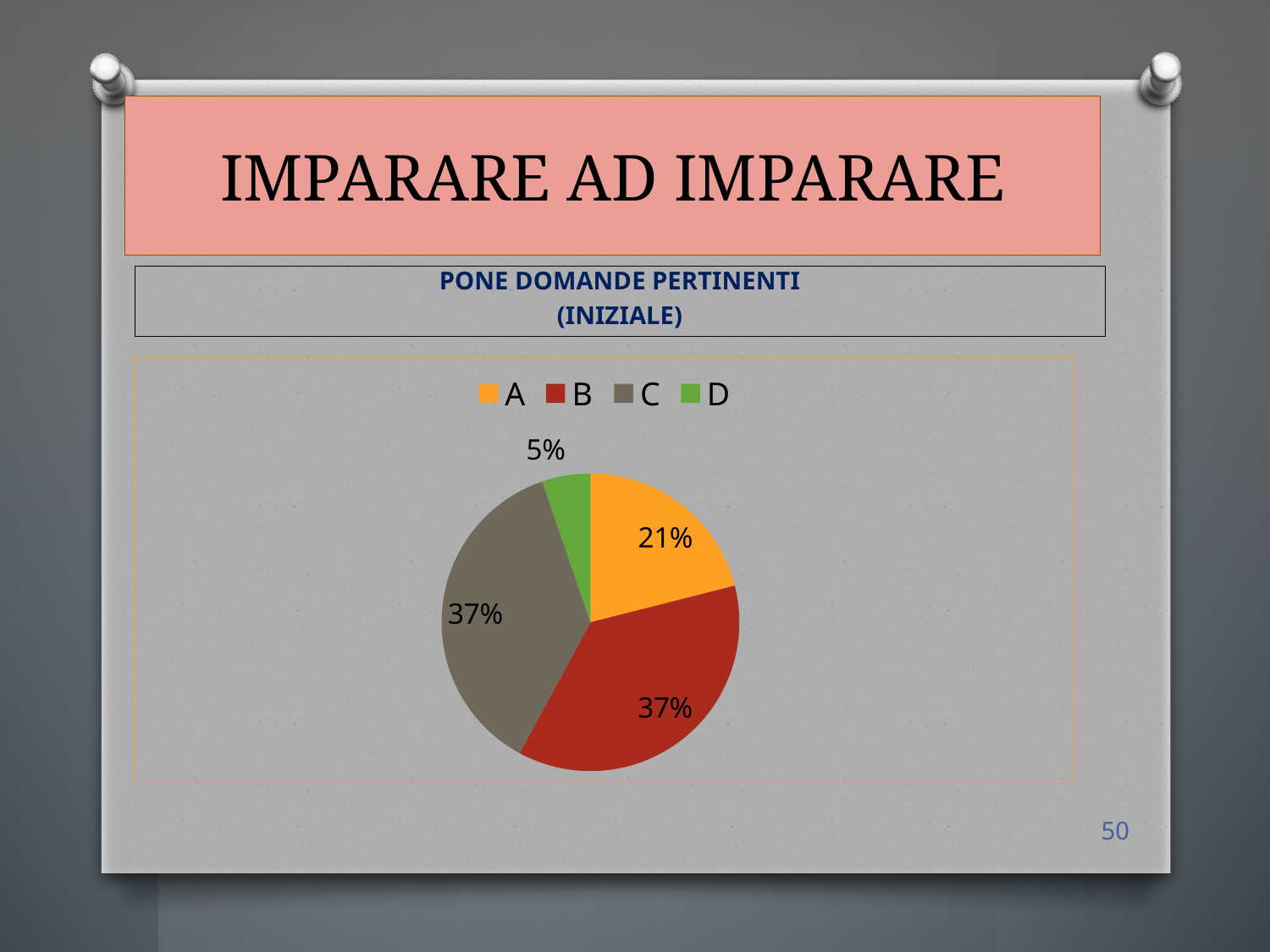
What is the difference in percentage points between slice A and slice D? 16% What percentage of the pie does slice A represent? 21% What kind of chart is shown on the slide? pie chart What is the title shown in the box above the pie chart? PONE DOMANDE PERTINENTI (INIZIALE) What percentage of the pie does slice D represent? 5% What is the difference in percentage points between slice B and slice A? 16% What percentage of the pie does slice B represent? 37% How many entries does the legend list? 4 Which category has the smallest slice of the pie? D Which is larger, the slice for A or the slice for D? A What percentage of the pie does slice C represent? 37% How many slices does the pie chart have? 4